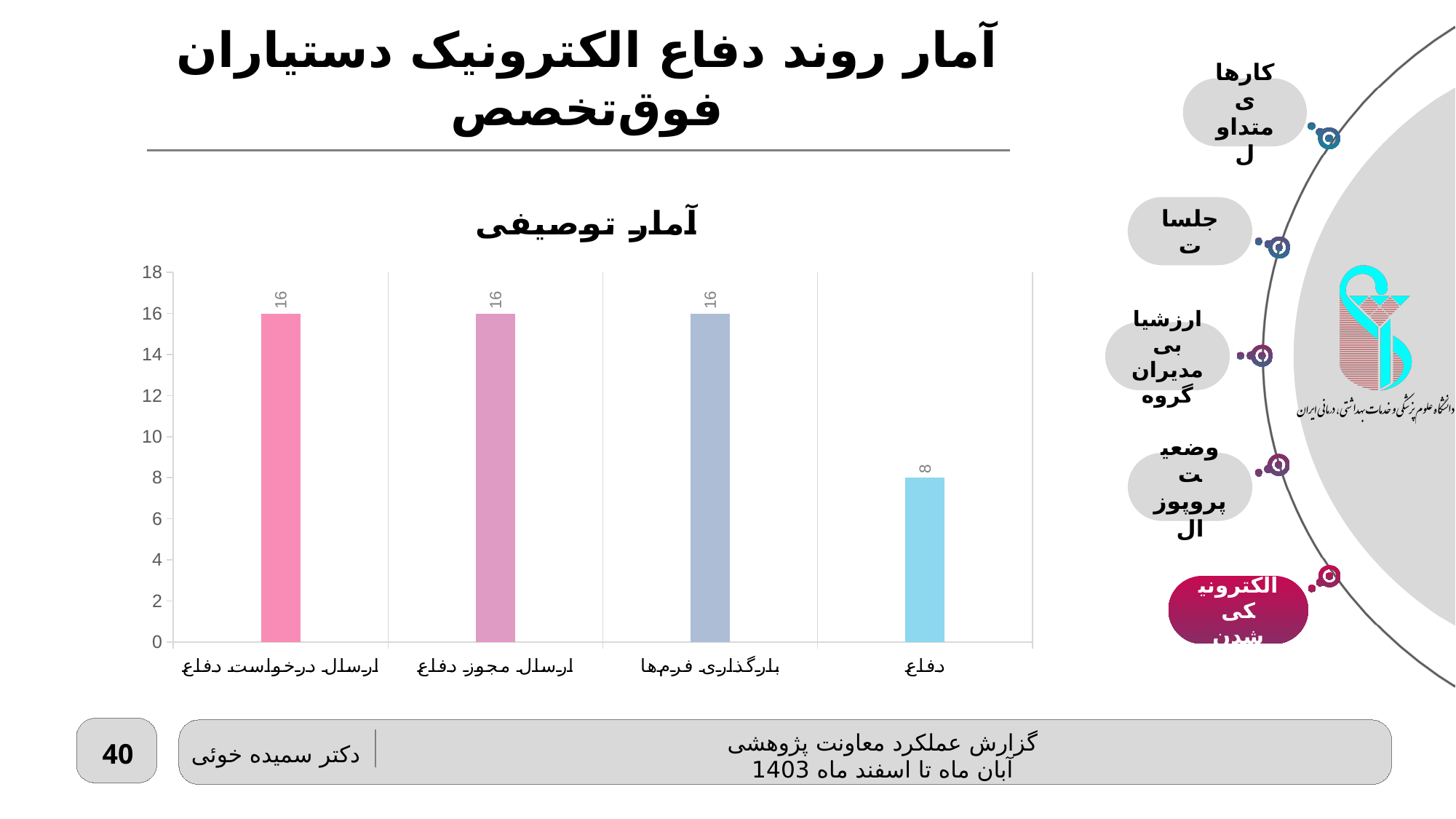
What is the highest value shown on the vertical axis? 18 What is the title of the chart? آمار توصیفی Is the value for دفاع greater or less than 10? less What is the value for بارگذاری فرم‌ها? 16 What is the value for دفاع? 8 What is the value for ارسال درخواست دفاع? 16 What kind of chart is shown on the slide? bar chart Which is larger, the value for ارسال مجوز دفاع or the value for دفاع? ارسال مجوز دفاع How many categories are shown in the chart? 4 What is the value for ارسال مجوز دفاع? 16 Which category has the lowest value? دفاع What is the difference between the values for بارگذاری فرم‌ها and دفاع? 8